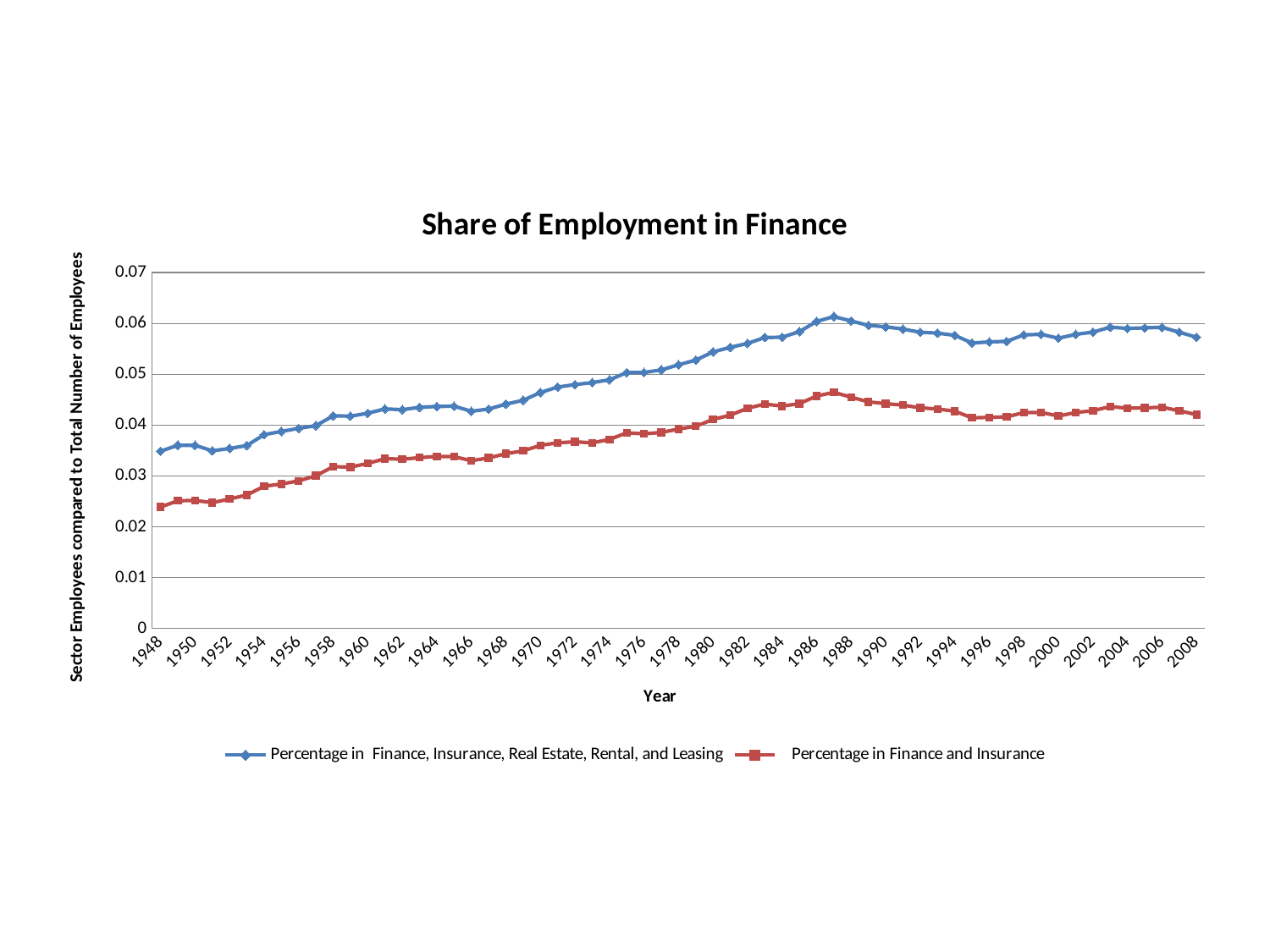
Is the value for Percentage in Finance, Insurance, Real Estate, Rental, and Leasing in 2008 greater or less than 0.06? less Does the Percentage in Finance, Insurance, Real Estate, Rental, and Leasing series rise or fall between 1966 and 1986? rise How many series does the legend list? 2 Is the value for Percentage in Finance and Insurance in 2008 greater or less than 0.04? greater Does the Percentage in Finance and Insurance series rise or fall between 1948 and 1986? rise Is the value for Percentage in Finance and Insurance in 1988 greater or less than 0.05? less In 1980, which series has the larger value: Percentage in Finance, Insurance, Real Estate, Rental, and Leasing or Percentage in Finance and Insurance? Percentage in Finance, Insurance, Real Estate, Rental, and Leasing What is the label of the x axis? Year What is the title of the chart? Share of Employment in Finance What type of chart is shown on the slide? line chart